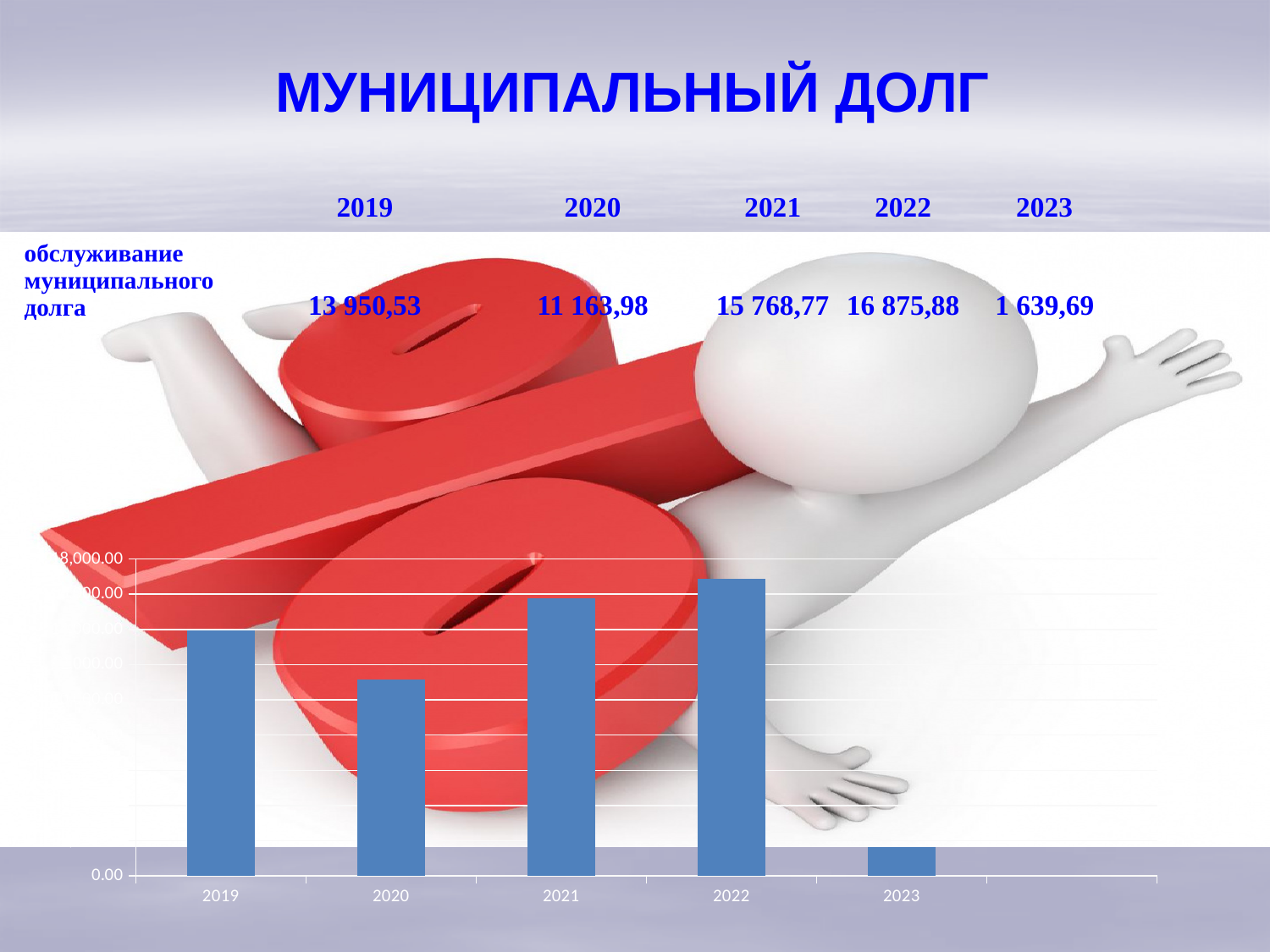
Which year has the lowest value in the bar chart? 2023 What kind of chart is shown on the slide? bar chart What is the value for 2021 for обслуживание муниципального долга? 15 768,77 What is the difference between the values for 2021 and 2020? 4 604,79 What is the value for 2023 for обслуживание муниципального долга? 1 639,69 How many years are shown on the x axis of the bar chart? 5 What is the title of the slide? МУНИЦИПАЛЬНЫЙ ДОЛГ What is the difference between the values for 2022 and 2023? 15 236,19 Which year has the highest value in the bar chart? 2022 What is the value for 2019 for обслуживание муниципального долга? 13 950,53 Which is larger, the value for 2019 or the value for 2020? 2019 Is the value for 2022 greater or less than 18,000.00? less